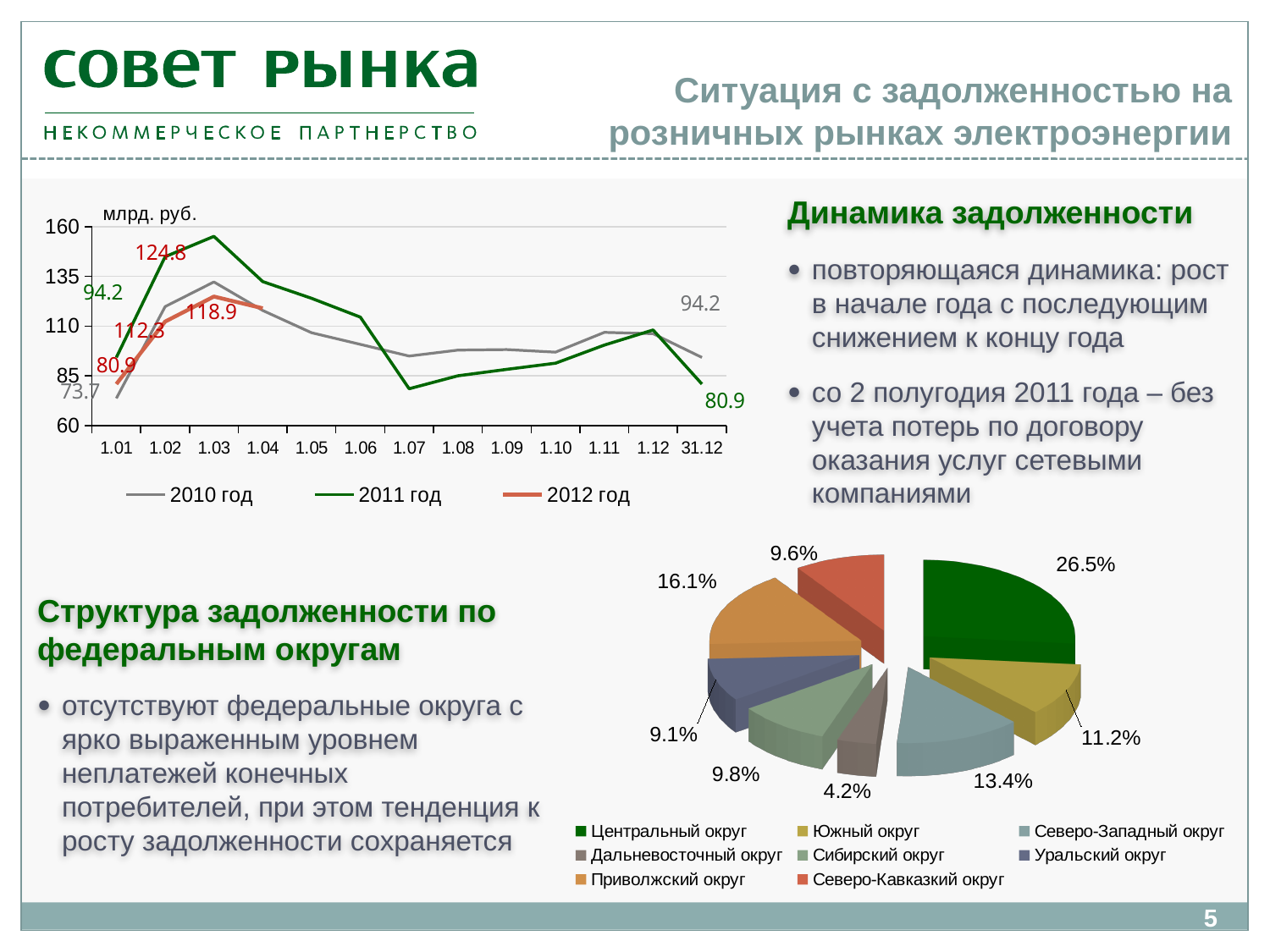
In the pie chart, which federal district has the largest share? Центральный округ How many series does the legend of the top-left line chart list? 3 In the top-left line chart, is the value for 2011 год at 1.03 greater or less than 135? greater How many slices does the pie chart have? 8 In the top-left line chart, what is the value for 2011 год at 31.12? 80.9 In the pie chart, which is larger: Северо-Западный округ or Южный округ? Северо-Западный округ In the top-left line chart, what is the value for 2010 год at 1.01? 73.7 In the pie chart, which federal district has the smallest share? Дальневосточный округ What kind of chart is the top-left chart showing debt in млрд. руб.? line chart In the pie chart, what is the share of Приволжский округ? 16.1%